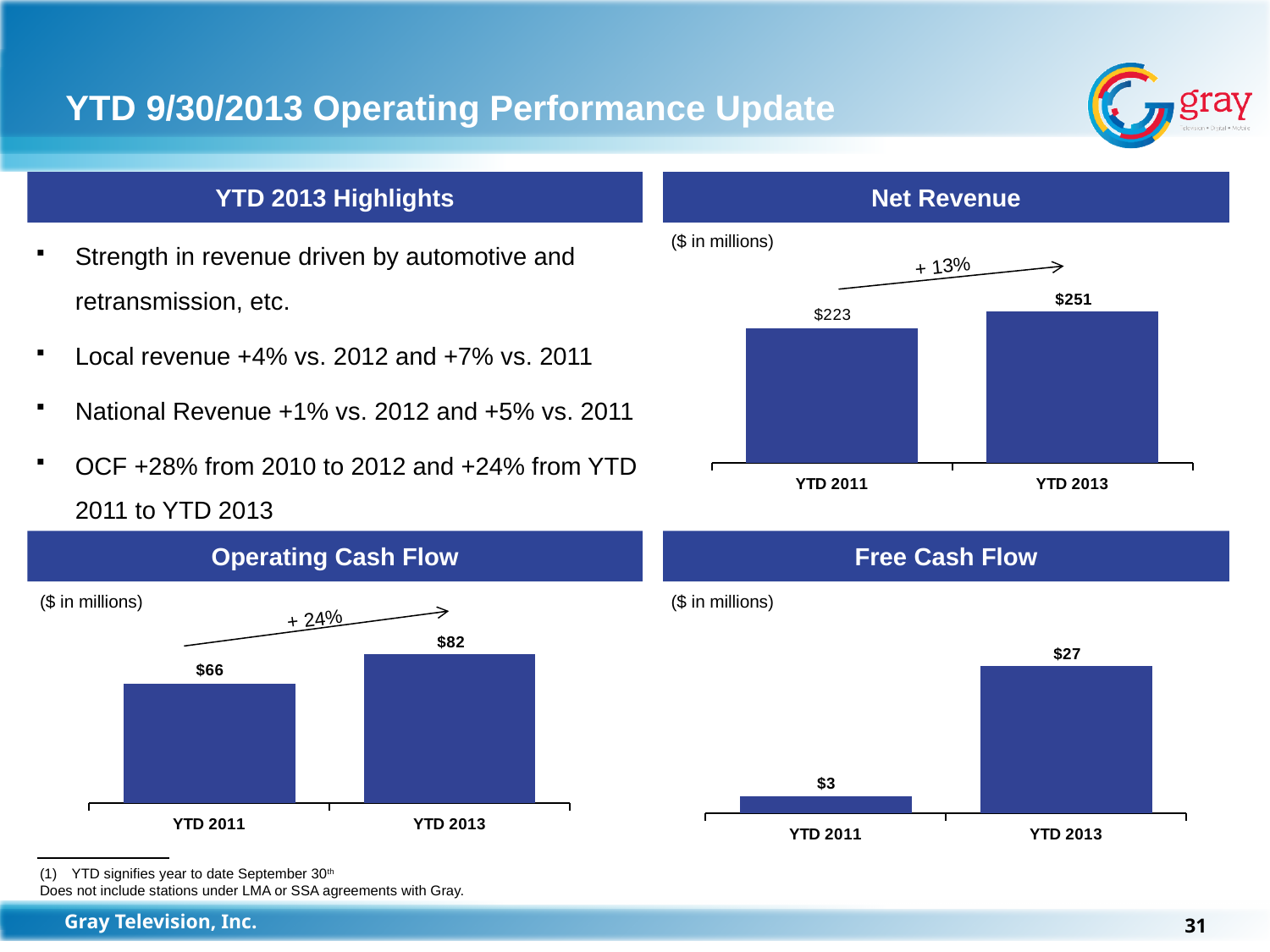
In the Operating Cash Flow chart, what is the value for YTD 2013? $82 In the Free Cash Flow chart, what is the value for YTD 2011? $3 What kind of chart is the Net Revenue chart? Bar chart How many categories are shown in the Operating Cash Flow chart? 2 In the Operating Cash Flow chart, what is the value for YTD 2011? $66 In the Free Cash Flow chart, what is the value for YTD 2013? $27 In the Operating Cash Flow chart, what percentage change is shown between YTD 2011 and YTD 2013? + 24% In the Net Revenue chart, what is the value for YTD 2013? $251 In the Free Cash Flow chart, which period has the higher value? YTD 2013 In the Net Revenue chart, what is the value for YTD 2011? $223 In the Free Cash Flow chart, what is the difference between YTD 2013 and YTD 2011? $24 In the Net Revenue chart, what is the difference between YTD 2013 and YTD 2011? $28